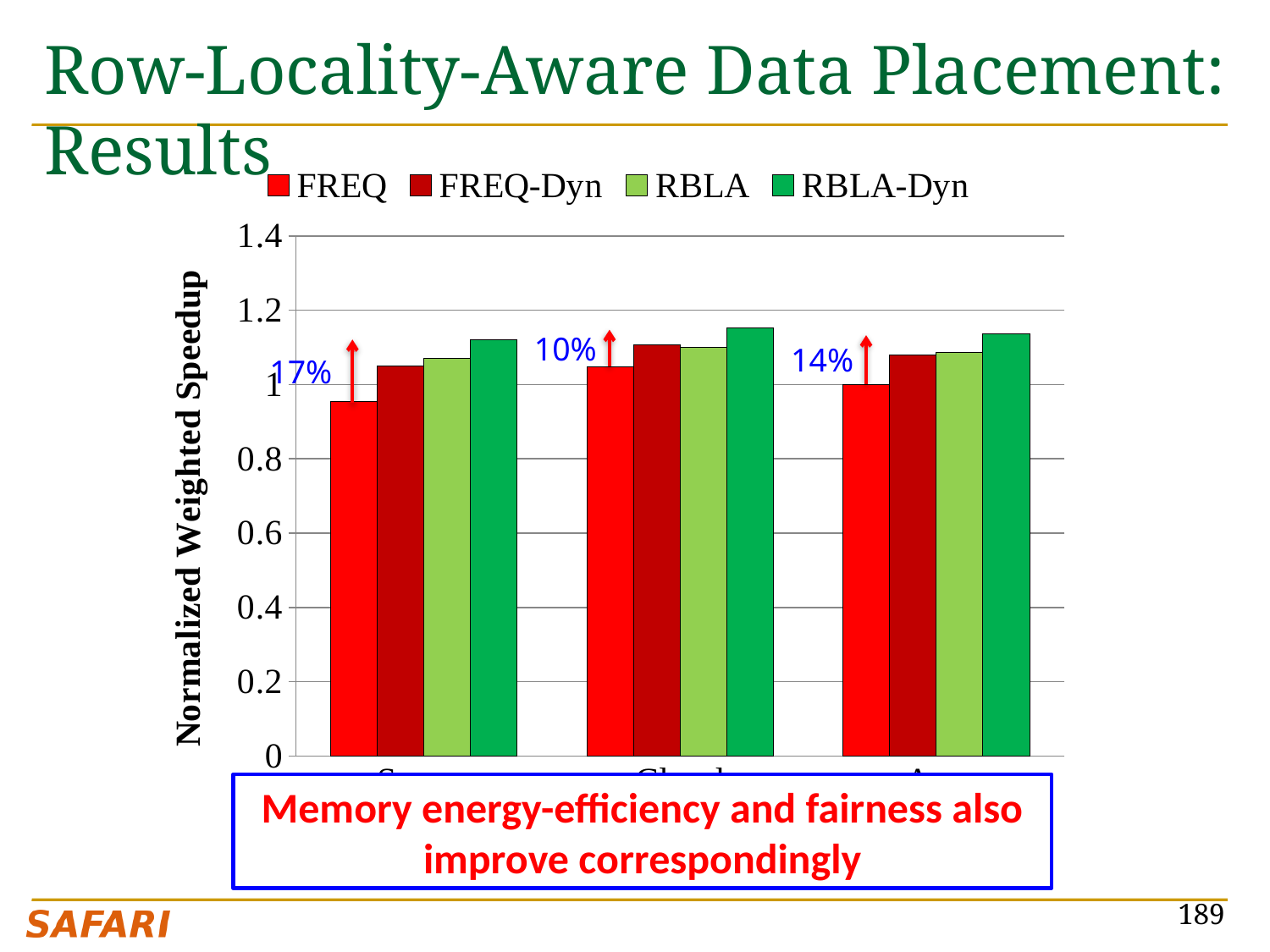
What percentage improvement is annotated above the middle group of bars? 10% Is the value of the RBLA-Dyn bar in the middle group greater or less than 1.2? less In the leftmost group, which series has the shortest bar? FREQ What are the four series named in the legend? FREQ, FREQ-Dyn, RBLA, RBLA-Dyn What is the title of the y axis? Normalized Weighted Speedup How many series does the legend list? 4 In the leftmost group, which series has the tallest bar? RBLA-Dyn What kind of chart is shown on the slide? bar chart Is the value of the FREQ bar in the leftmost group greater or less than 1? less How many groups of bars are plotted in the chart? 3 Is the value of the RBLA-Dyn bar in the leftmost group greater or less than 1? greater In the leftmost group, which is larger: the FREQ bar or the RBLA-Dyn bar? RBLA-Dyn